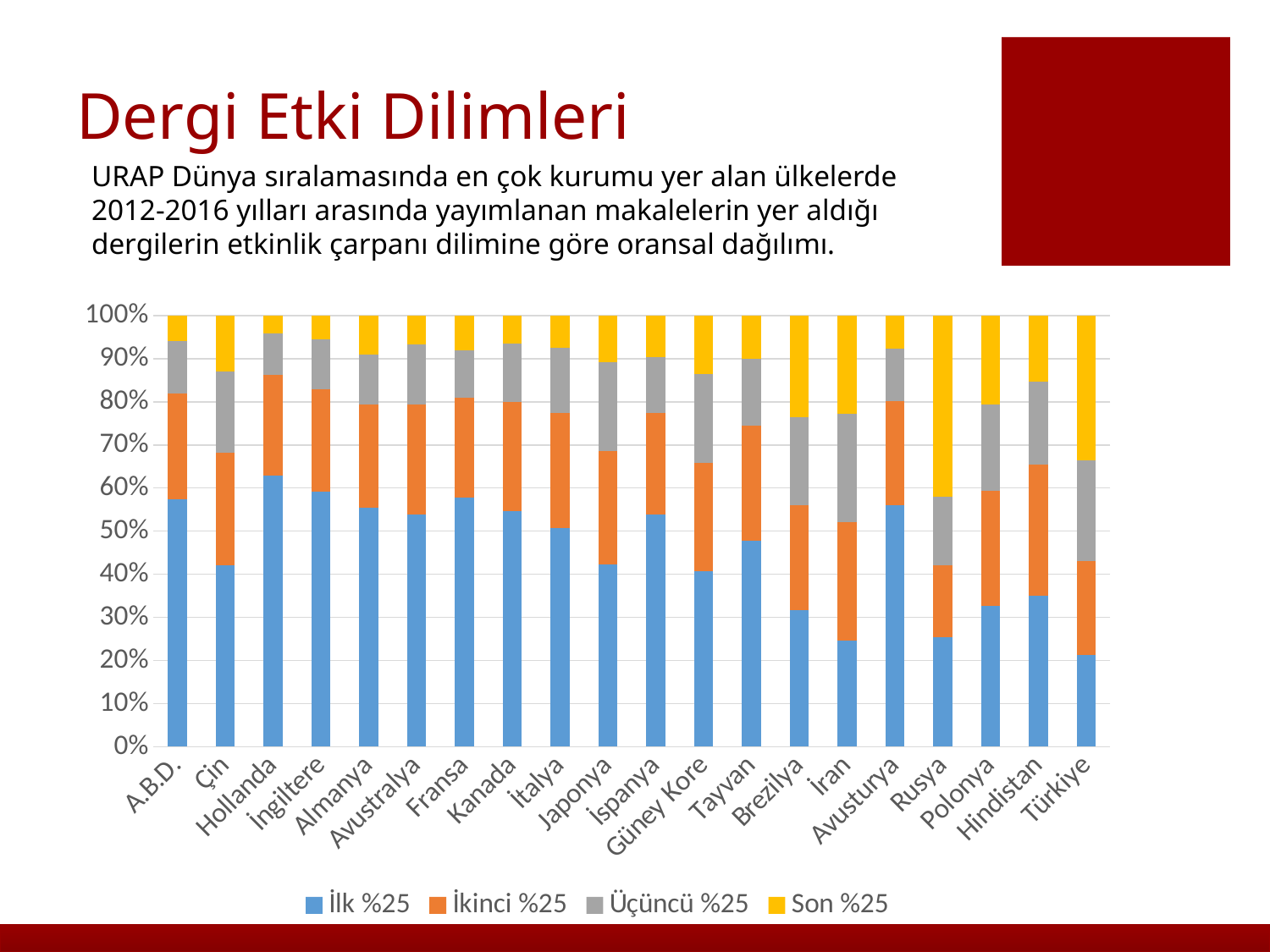
Is the İlk %25 value for Brezilya greater or less than 40%? less Which country has the largest İlk %25 segment? Hollanda What kind of chart is shown on the slide? Stacked bar chart Which has the larger İlk %25 segment, A.B.D. or Çin? A.B.D. Is the İlk %25 value for Çin greater or less than 50%? less Which country has the smallest İlk %25 segment? Türkiye Is the İlk %25 value for Hollanda greater or less than 60%? greater How many countries are shown on the x axis of the chart? 20 Which country has the largest Son %25 segment? Rusya What are the four series listed in the chart legend? İlk %25, İkinci %25, Üçüncü %25, Son %25 How many series does the chart legend list? 4 What is the title of the slide containing the chart? Dergi Etki Dilimleri